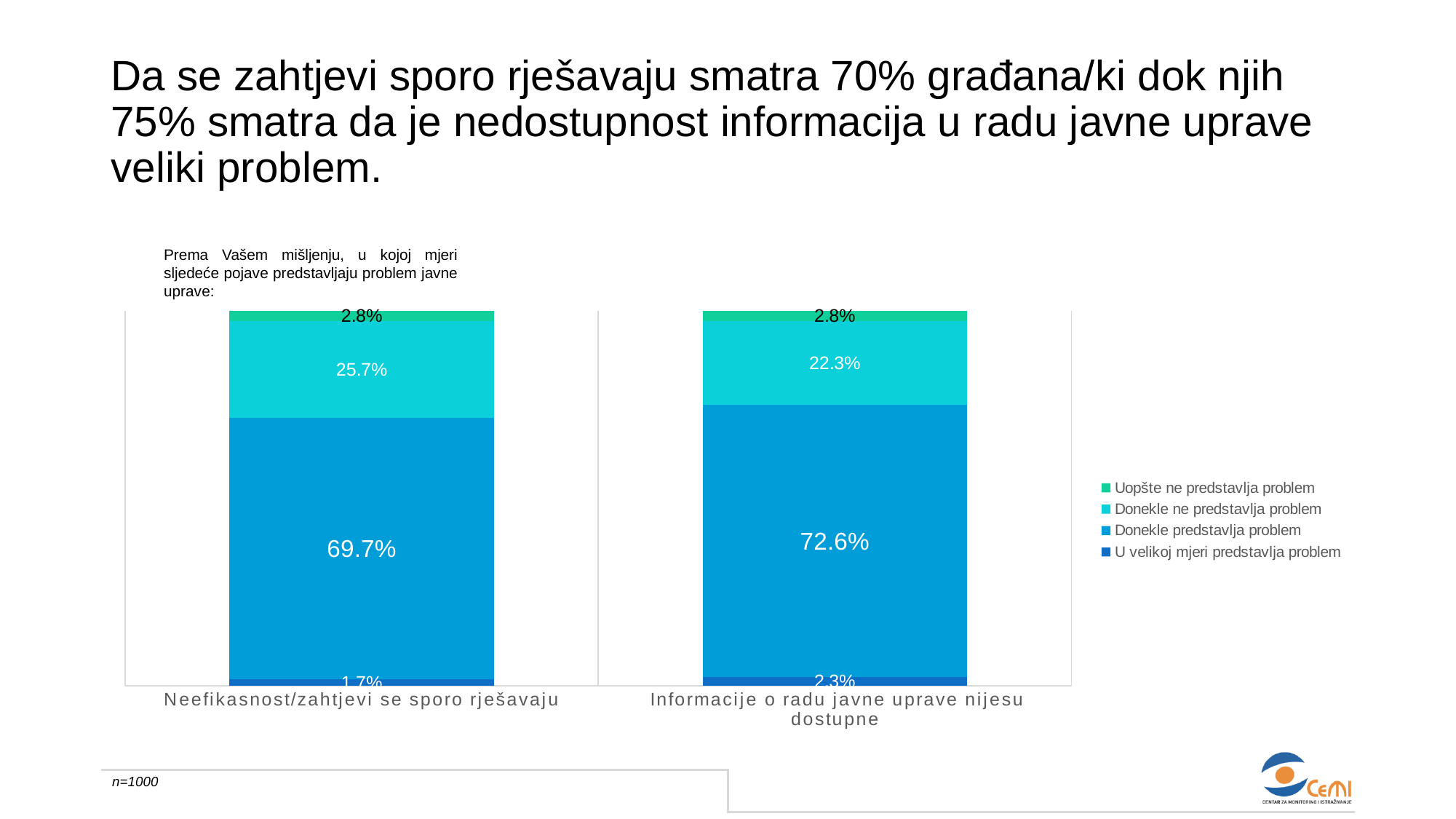
What is the value of the largest segment in the 'Informacije o radu javne uprave nijesu dostupne' bar? 72.6% What is the value of the 'Uopšte ne predstavlja problem' segment for 'Neefikasnost/zahtjevi se sporo rješavaju'? 2.8% What kind of chart is shown on the slide? Stacked bar chart What is the value of the 'Donekle ne predstavlja problem' segment for 'Informacije o radu javne uprave nijesu dostupne'? 22.3% How many categories are shown on the x axis of the chart? 2 What is the difference between the largest segments of the two bars (72.6% and 69.7%)? 2.9 percentage points What sample size is noted at the bottom of the slide? n=1000 What is the value of the bottom segment of the 'Informacije o radu javne uprave nijesu dostupne' bar? 2.3% How many series does the chart legend list? 4 Which category has the larger value for its largest segment: 'Neefikasnost/zahtjevi se sporo rješavaju' or 'Informacije o radu javne uprave nijesu dostupne'? Informacije o radu javne uprave nijesu dostupne What is the value of the largest segment in the 'Neefikasnost/zahtjevi se sporo rješavaju' bar? 69.7% What is the value of the bottom segment of the 'Neefikasnost/zahtjevi se sporo rješavaju' bar? 1.7%